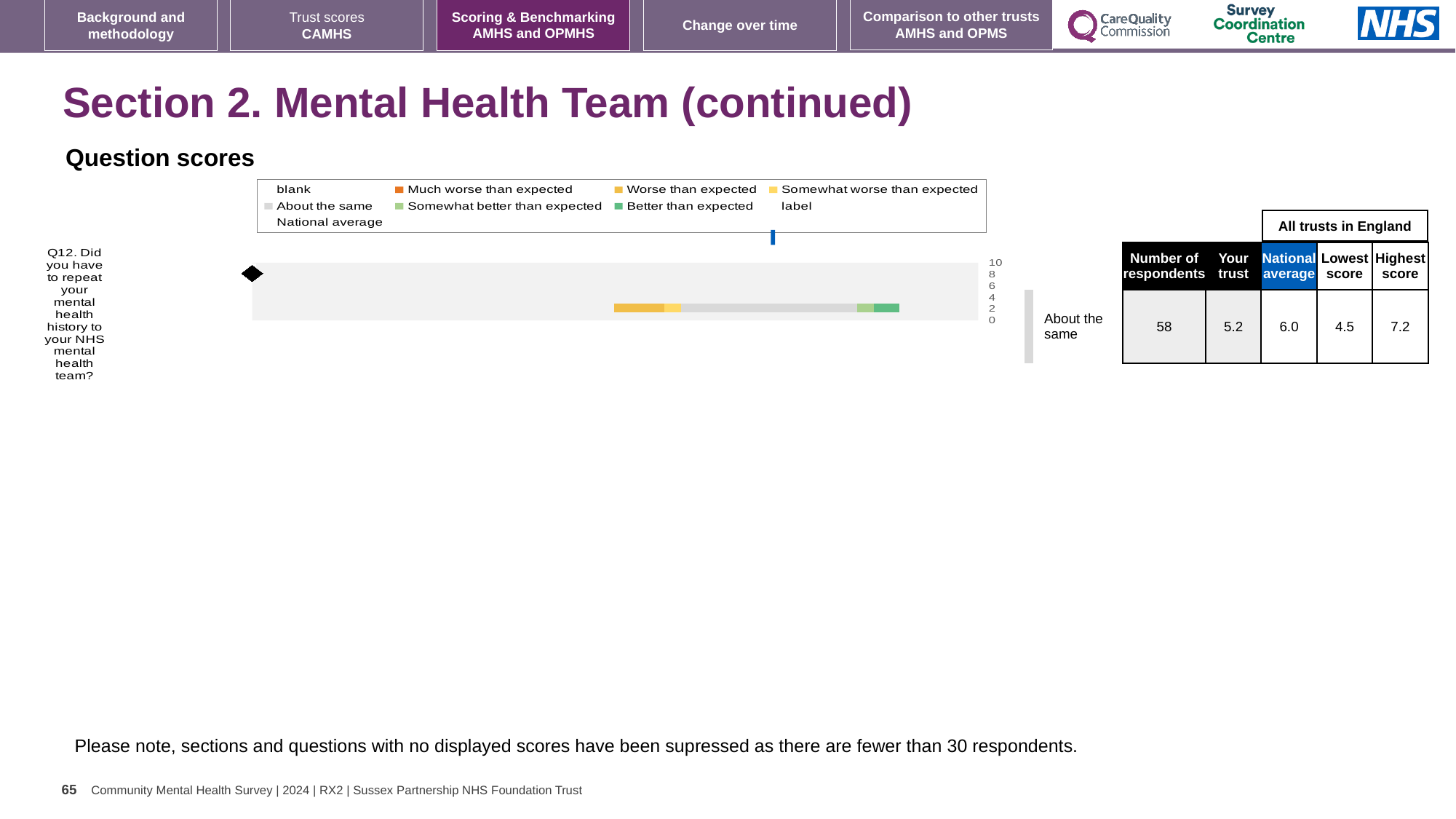
Which question is plotted in the Question scores chart? Q12. Did you have to repeat your mental health history to your NHS mental health team? In the legend of the Question scores chart, which entry is shown in orange? Much worse than expected What kind of chart is used to show the Q12 question score? bar chart In the table beside the Question scores chart, what is the 'Your trust' score for Q12? 5.2 For Q12, which is larger: the 'Your trust' score or the national average? national average In the table beside the Question scores chart, what is the number of respondents for Q12? 58 In the table beside the Question scores chart, what is the lowest score among all trusts in England for Q12? 4.5 In the table beside the Question scores chart, what is the national average for Q12? 6.0 How many questions are plotted in the Question scores chart? 1 What benchmark category label is shown next to the Q12 bar in the Question scores chart? About the same For Q12, what is the difference between the highest score and the lowest score among all trusts in England? 2.7 In the table beside the Question scores chart, what is the highest score among all trusts in England for Q12? 7.2